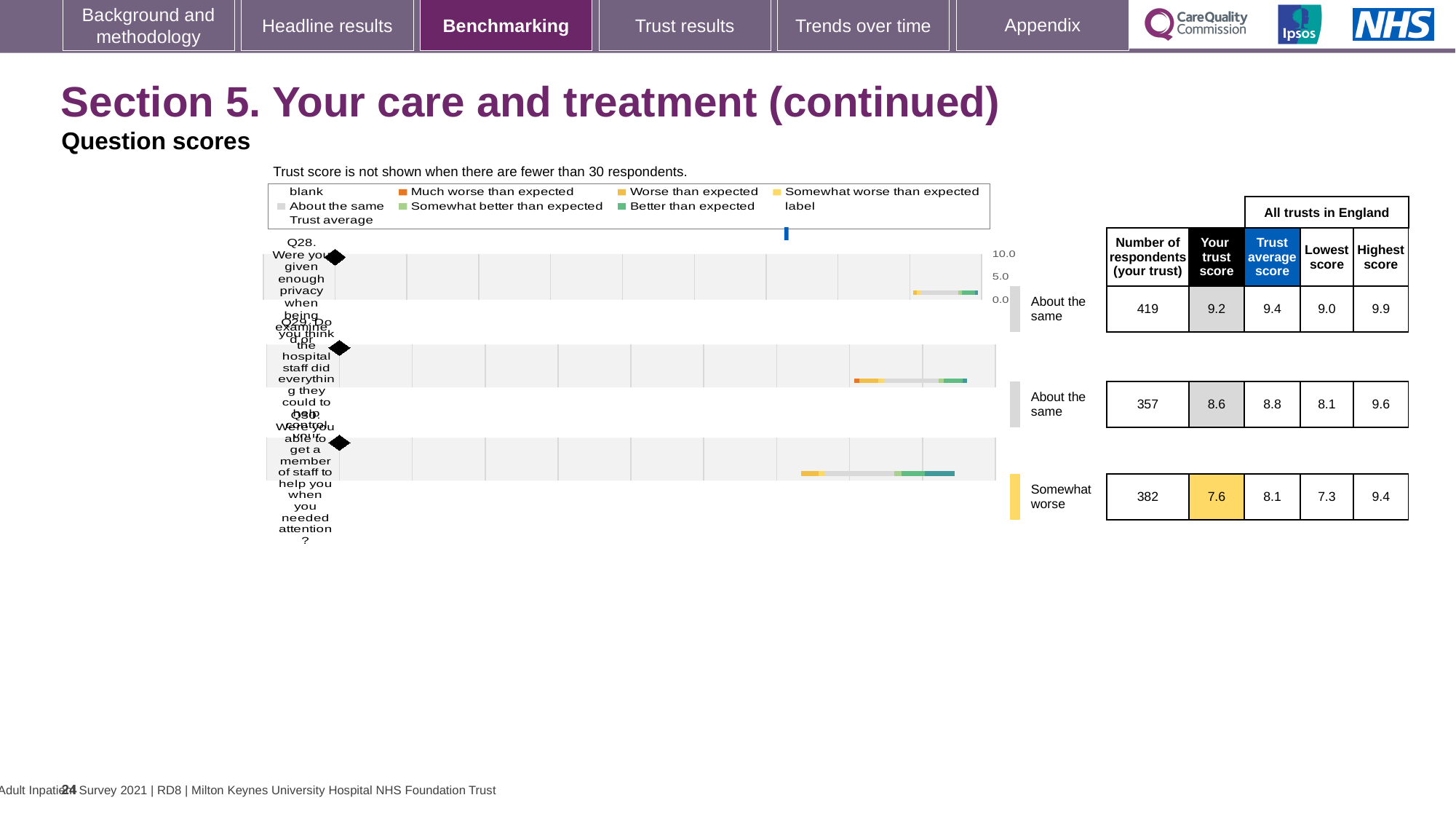
What is the difference between the trust average score and the trust score for Q30? 0.5 Is the trust score for Q29 larger or smaller than the trust average score for Q29? smaller Which question (Q28, Q29 or Q30) has the lowest trust score? Q30 What is the trust score for Q28? 9.2 What benchmarking category is shown for Q30? Somewhat worse What is the trust score for Q30? 7.6 What kind of chart is used to show the question scores? bar chart How many questions are plotted on the slide? 3 What is the trust average score for Q29? 8.8 How many respondents answered Q29? 357 What is the highest score across all trusts in England for Q28? 9.9 Which question (Q28, Q29 or Q30) has the highest trust score? Q28